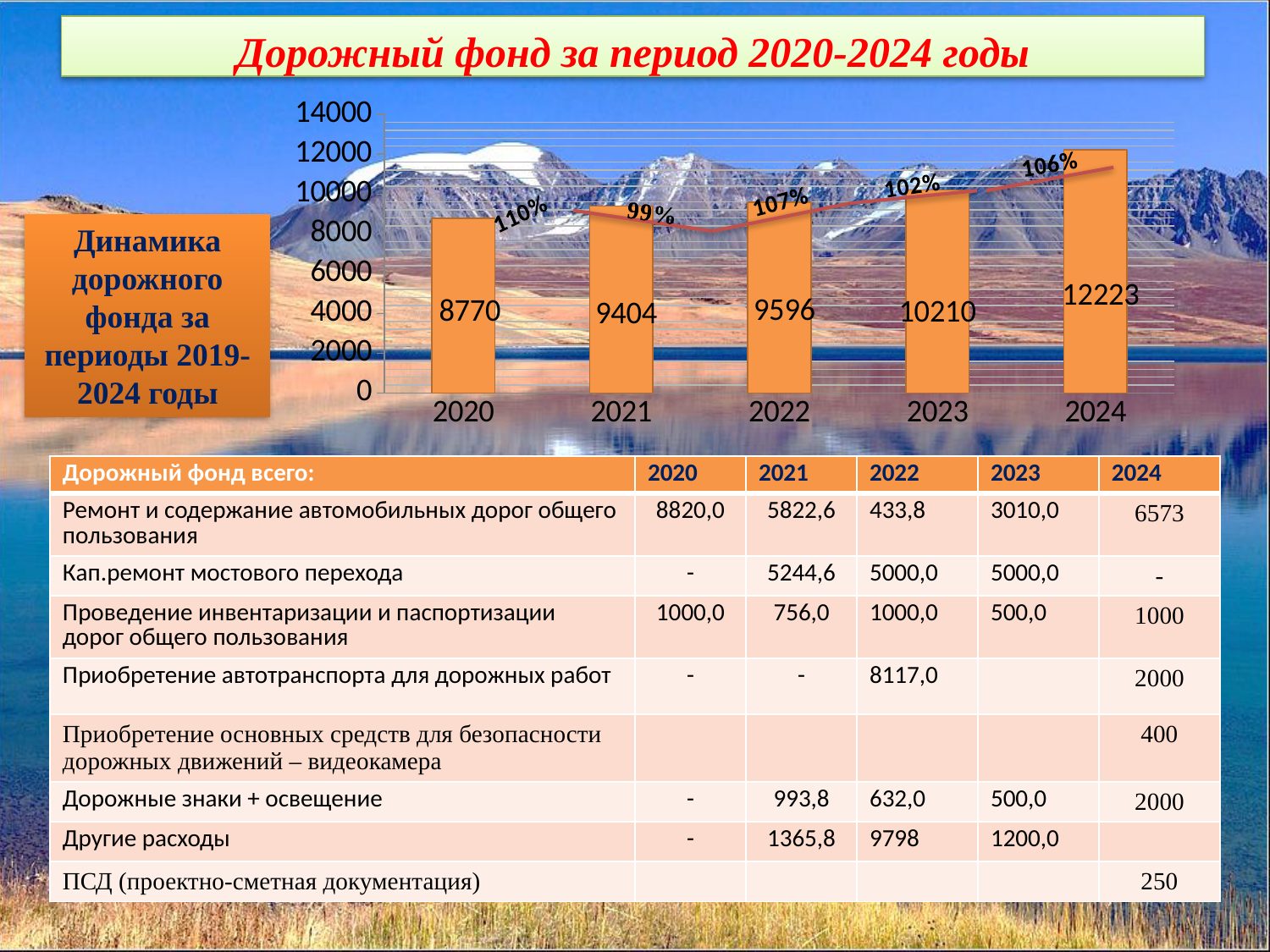
Is the bar value for 2024 greater or less than 12000? greater Which year has the highest bar in the chart? 2024 What kind of chart is shown on the slide? bar chart with a line How many years are shown on the x axis of the chart? 5 Which year has the lowest bar in the chart? 2020 What is the difference between the bar values for 2021 and 2020? 634 What is the value of the bar for 2024 in the chart? 12223 What is the difference between the bar values for 2024 and 2023? 2013 What is the value of the bar for 2020 in the chart? 8770 What is the value of the bar for 2022 in the chart? 9596 Which is larger, the bar for 2023 or the bar for 2022? 2023 What percentage label is shown on the line above the 2021 bar? 99%